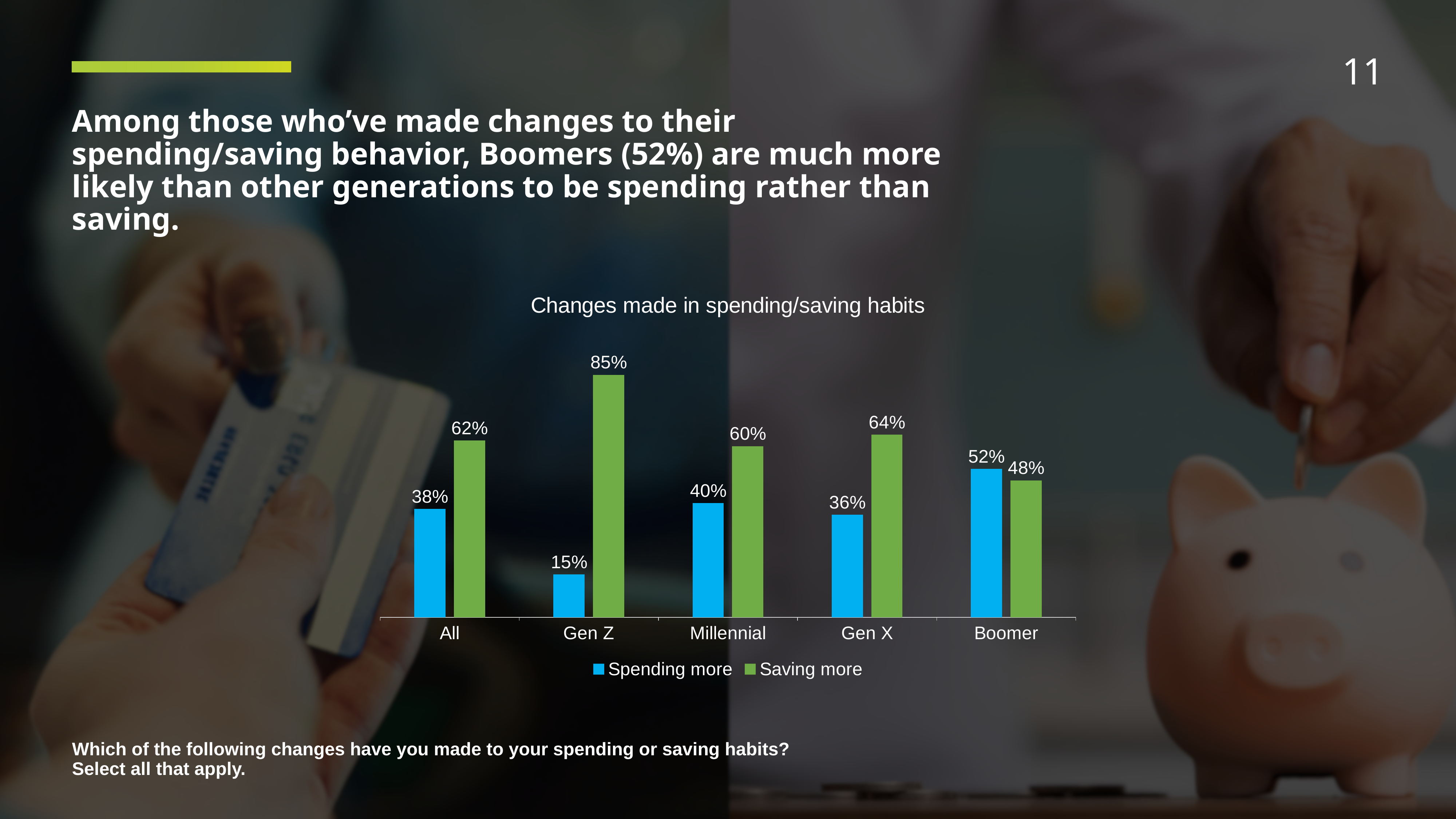
What is the title of the chart? Changes made in spending/saving habits Which category has the highest Saving more value? Gen Z How many series does the legend list? 2 What is the difference between Spending more for Boomer and Spending more for Gen X? 16% What is the value for Saving more for Millennial? 60% What is the difference between Saving more and Spending more for Gen Z? 70% Which category has the lowest Spending more value? Gen Z What kind of chart is shown on the slide? Bar chart Which is larger for Boomer, Spending more or Saving more? Spending more What is the value for Spending more for Gen Z? 15% What is the value for Spending more for Boomer? 52% How many categories are shown on the x axis? 5